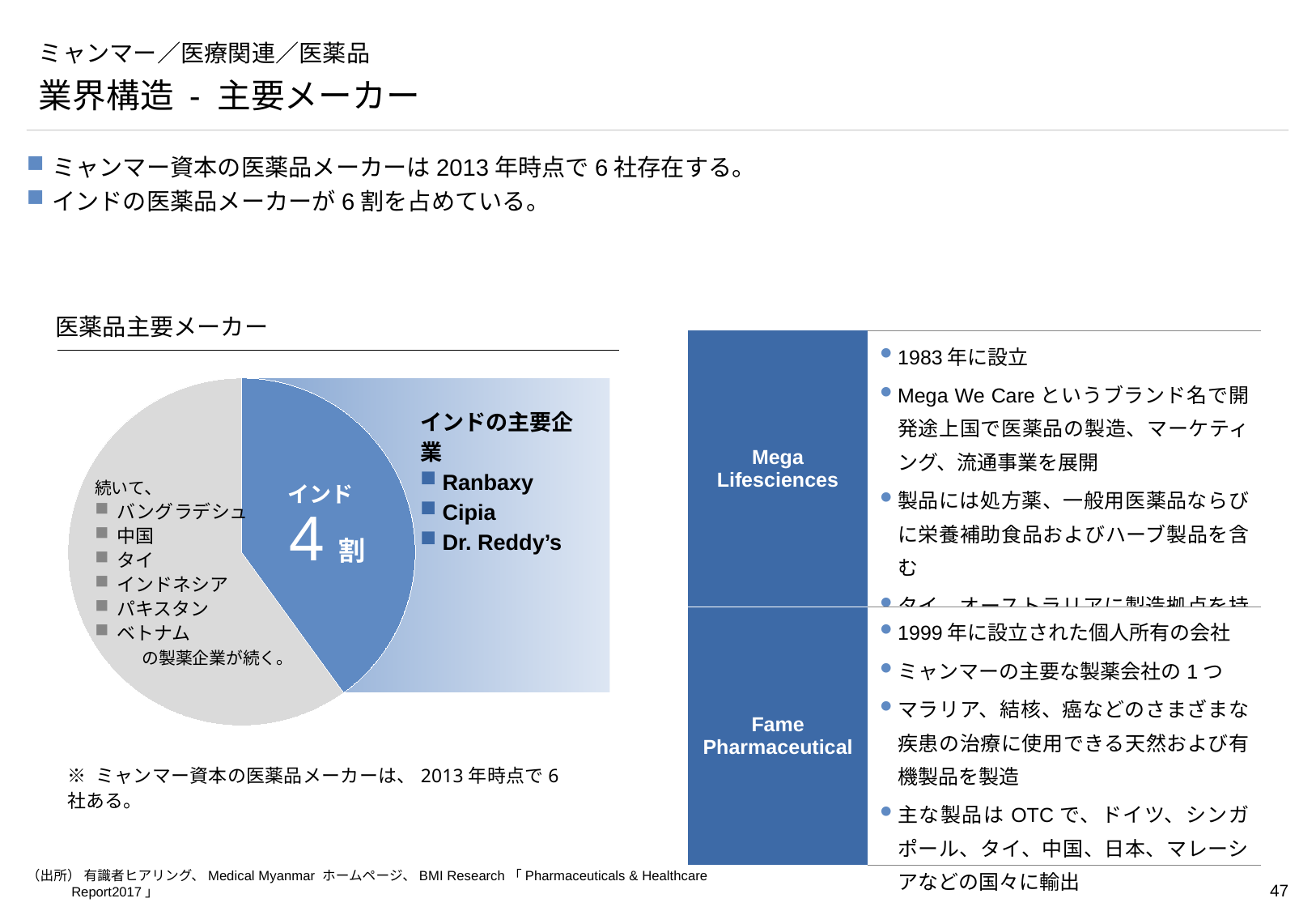
How many Indian companies are listed next to the インド slice under インドの主要企業? 3 What kind of chart is shown under the heading 医薬品主要メーカー? Pie chart What colour is the インド slice in the 医薬品主要メーカー pie chart? Blue How many countries are listed in the grey slice of the 医薬品主要メーカー pie chart after 続いて、? 6 In the 医薬品主要メーカー pie chart, is the インド slice larger or smaller than the remaining grey slice? Smaller What is the title of the pie chart on the slide? 医薬品主要メーカー How many slices does the 医薬品主要メーカー pie chart have? 2 Which country is listed first in the grey slice of the 医薬品主要メーカー pie chart? バングラデシュ In the 医薬品主要メーカー pie chart, what share is shown for インド? 4割 Which Indian companies are listed under インドの主要企業 in the pie chart? Ranbaxy, Cipia, Dr. Reddy's